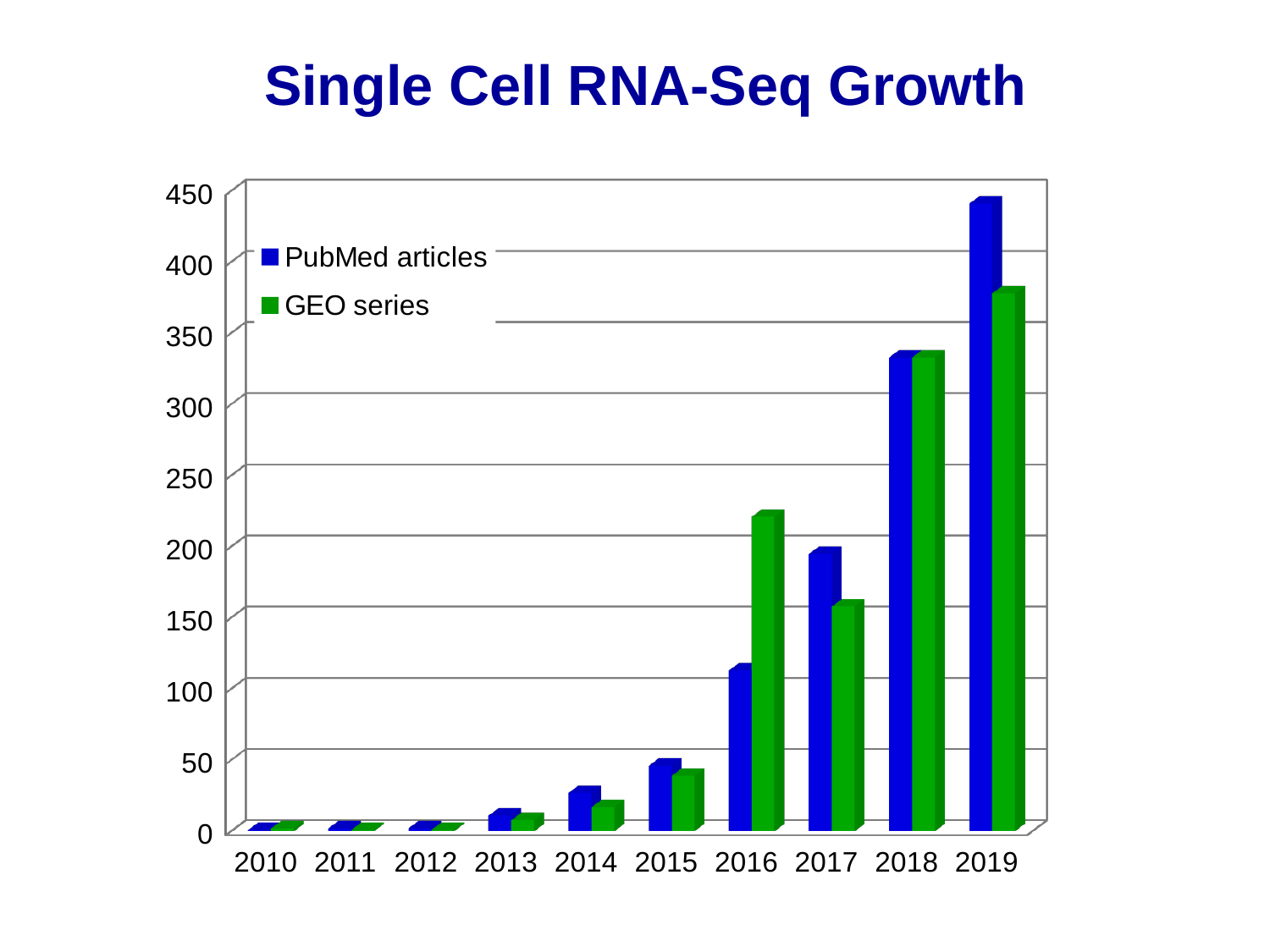
Do the PubMed articles values generally rise or fall from 2010 to 2019? rise Which year has the highest value for GEO series? 2019 Is the value for PubMed articles in 2018 greater or less than 300? greater Is the value for GEO series in 2019 greater or less than 400? less How many years are shown on the x axis? 10 Which year has the highest value for PubMed articles? 2019 Is the value for PubMed articles in 2019 greater or less than 400? greater In 2016, which is larger: PubMed articles or GEO series? GEO series What kind of chart is shown on the slide? bar chart How many series does the legend list? 2 In 2017, which is larger: PubMed articles or GEO series? PubMed articles